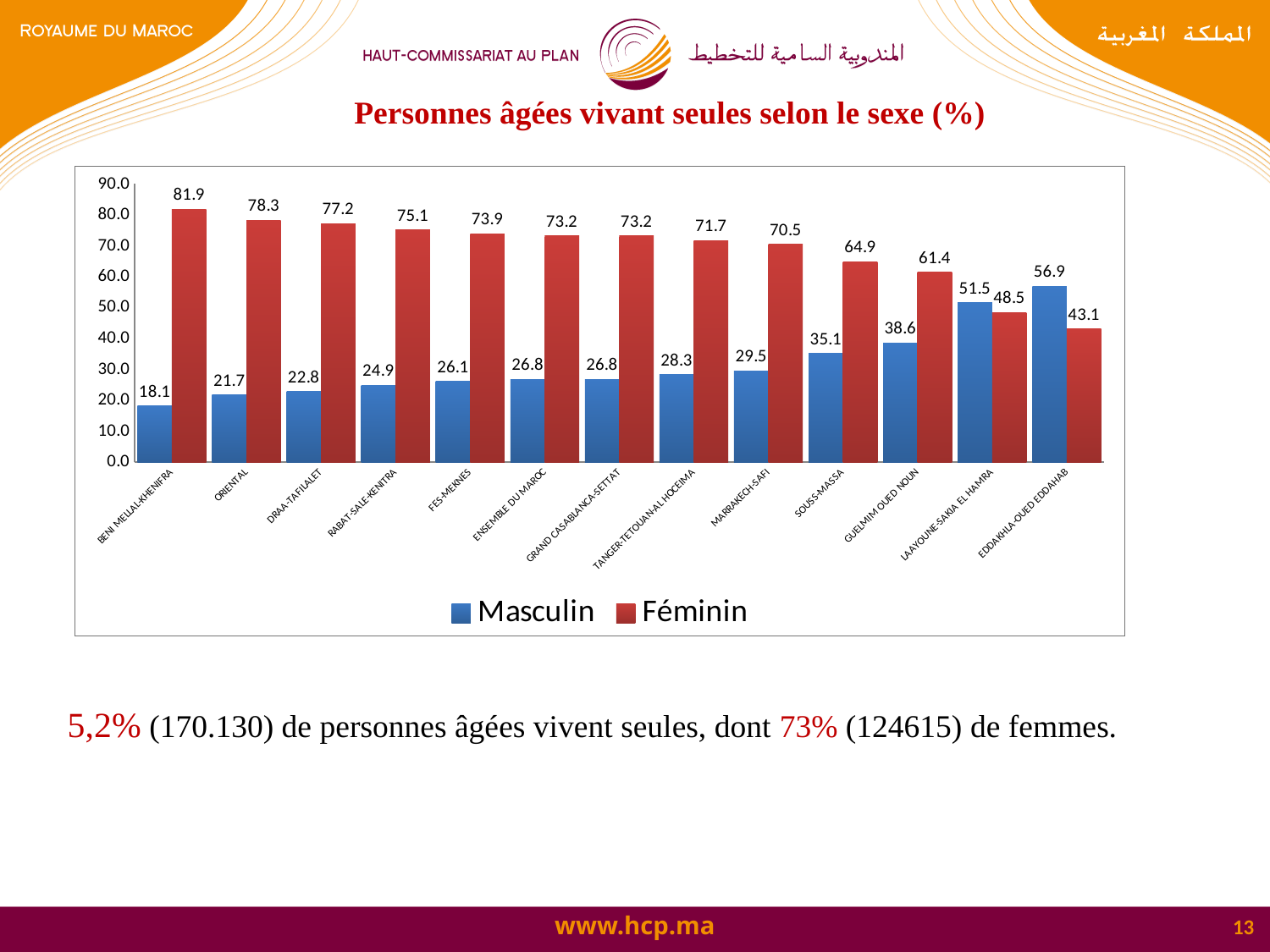
What is the Féminin value for BENI MELLAL-KHENIFRA? 81.9 What is the Masculin value for ENSEMBLE DU MAROC? 26.8 Which is larger for LAAYOUNE-SAKIA EL HAMRA, the Masculin value or the Féminin value? Masculin Which colour represents the Féminin series? red How many series does the legend list? 2 Which category has the lowest Masculin value? BENI MELLAL-KHENIFRA What kind of chart is shown on the slide? bar chart What is the difference between the Féminin and Masculin values for SOUSS-MASSA? 29.8 Is the Féminin value for GUELMIM OUED NOUN greater or less than 60.0? greater How many categories are shown on the x axis? 13 What is the Masculin value for EDDAKHLA-OUED EDDAHAB? 56.9 Which category has the highest Féminin value? BENI MELLAL-KHENIFRA